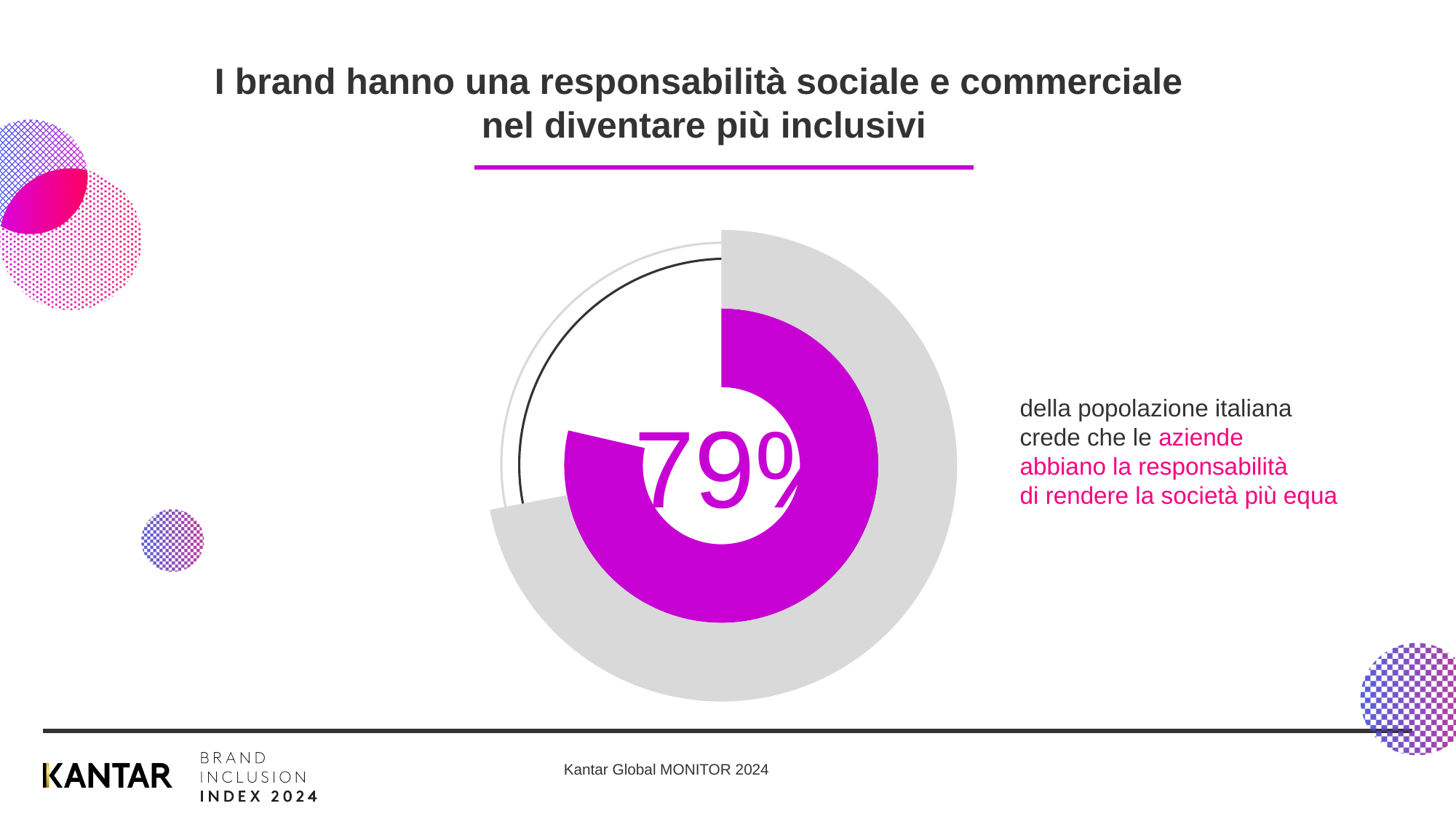
What is the title of the slide containing the donut chart? I brand hanno una responsabilità sociale e commerciale nel diventare più inclusivi According to the text next to the chart, what share of the Italian population believes companies have the responsibility to make society fairer? 79% What colour is the segment representing 79% in the donut chart? Magenta What percentage is printed in the centre of the donut chart? 79% What kind of chart is shown on the slide? Donut (pie) chart Is the magenta segment of the donut chart greater or less than 50%? greater What share of the donut chart does the magenta segment represent? 79%